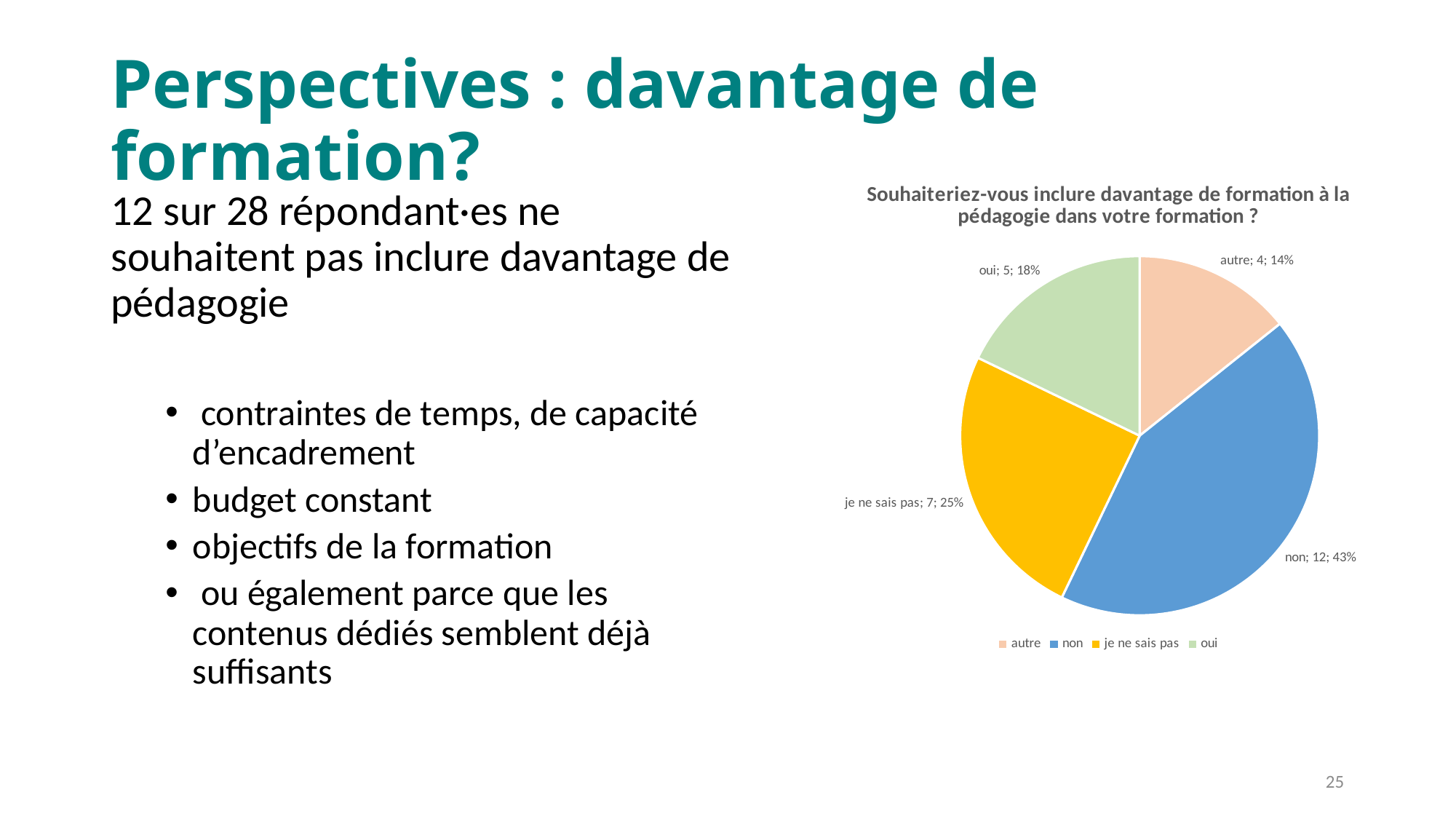
What percentage of the pie does the "oui" slice represent? 18% Which category has the smallest slice of the pie? autre Which is larger, the "je ne sais pas" slice or the "oui" slice? je ne sais pas Which category has the largest slice of the pie? non What kind of chart is shown on the slide? pie chart What is the difference in count between "non" and "oui"? 7 How many slices does the pie chart have? 4 What colour is the "non" slice in the pie chart? blue What is the title of the pie chart? Souhaiteriez-vous inclure davantage de formation à la pédagogie dans votre formation ? What percentage of the pie does the "autre" slice represent? 14% How many respondents answered "je ne sais pas"? 7 How many respondents answered "non"? 12